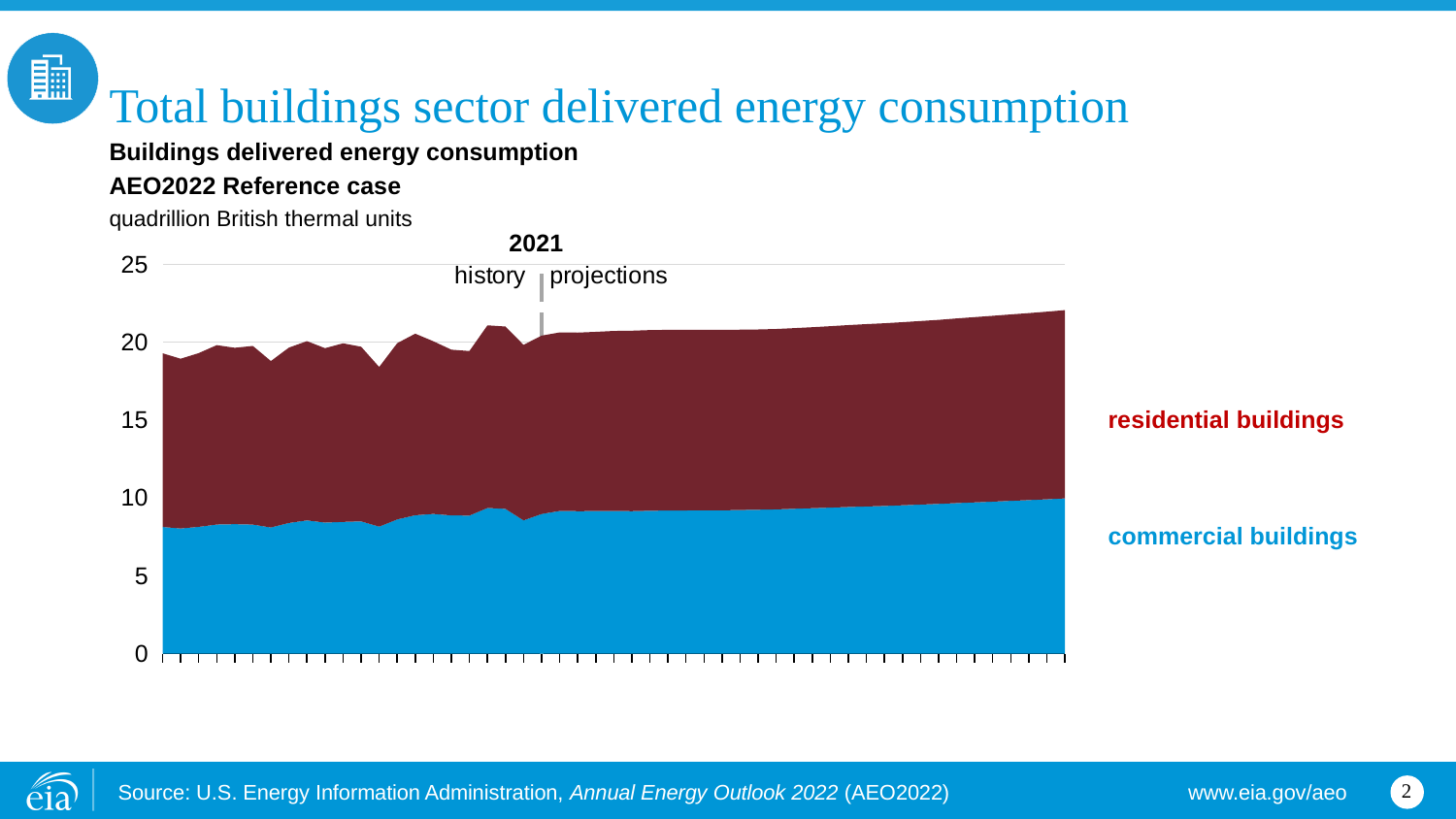
Which series accounts for the larger share of buildings delivered energy consumption, residential buildings or commercial buildings? residential buildings What are the two series shown in the chart? residential buildings and commercial buildings Is the total buildings delivered energy consumption at the end of the projection period greater or less than 20? greater What unit is the chart's vertical axis measured in? quadrillion British thermal units What kind of chart is shown on the slide? stacked area chart In which year does the chart switch from history to projections? 2021 Does total buildings delivered energy consumption rise or fall over the projection period? rise Is the total buildings delivered energy consumption at the end of the projection period greater or less than 25? less How many series does the chart show? 2 Is the commercial buildings value at the start of the history period greater or less than 10? less